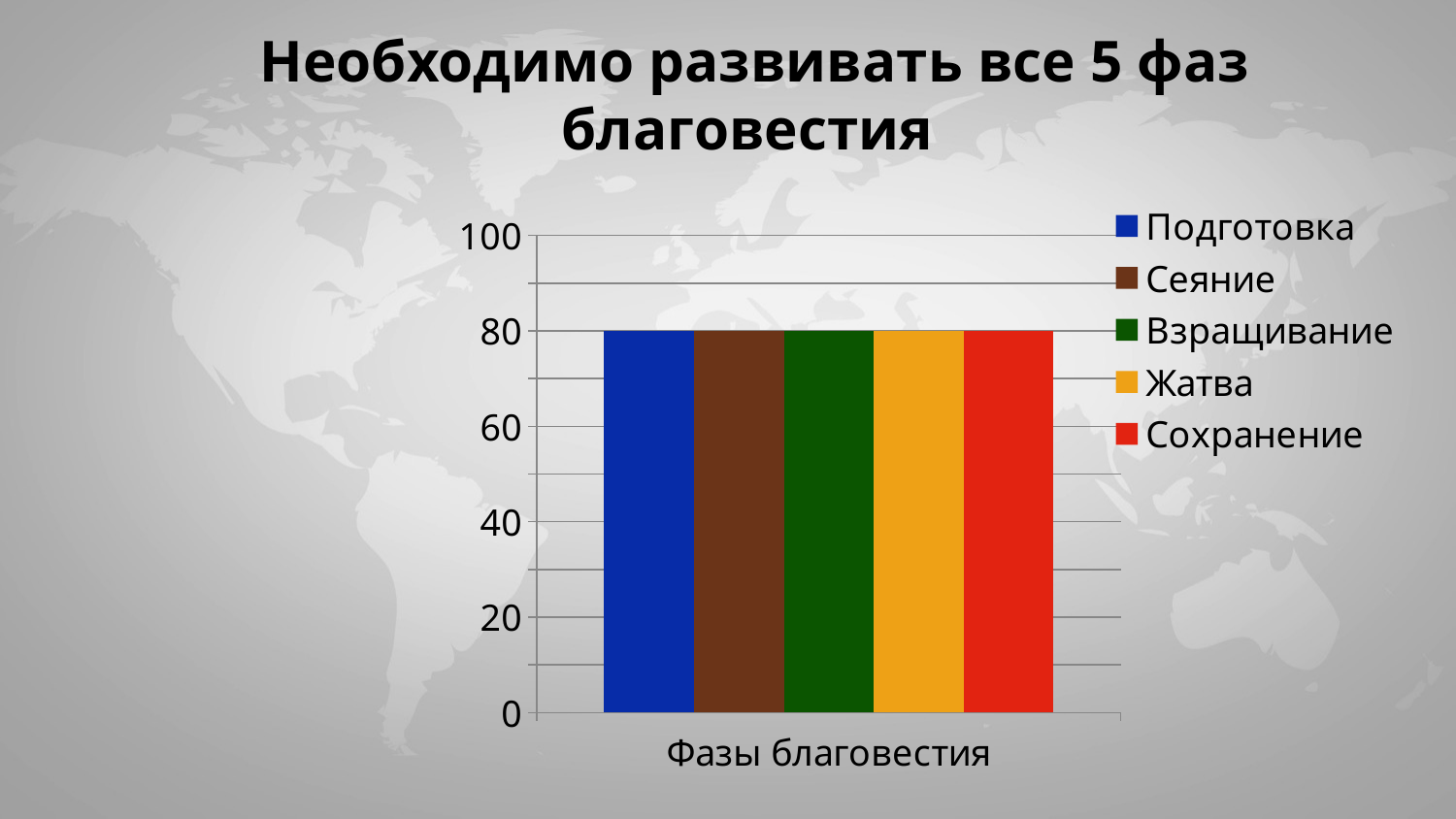
Is the value for Жатва greater or less than 60? greater Which colour represents Взращивание in the legend? green How many series does the legend list? 5 What is the value for Жатва? 80 Is the value for Сохранение greater or less than 100? less What is the value for Сеяние? 80 What is the value for Взращивание? 80 What is the difference between the values for Подготовка and Сеяние? 0 What is the value for Подготовка? 80 What kind of chart is shown on the slide? bar chart What is the value for Сохранение? 80 What is the category label shown on the x axis? Фазы благовестия